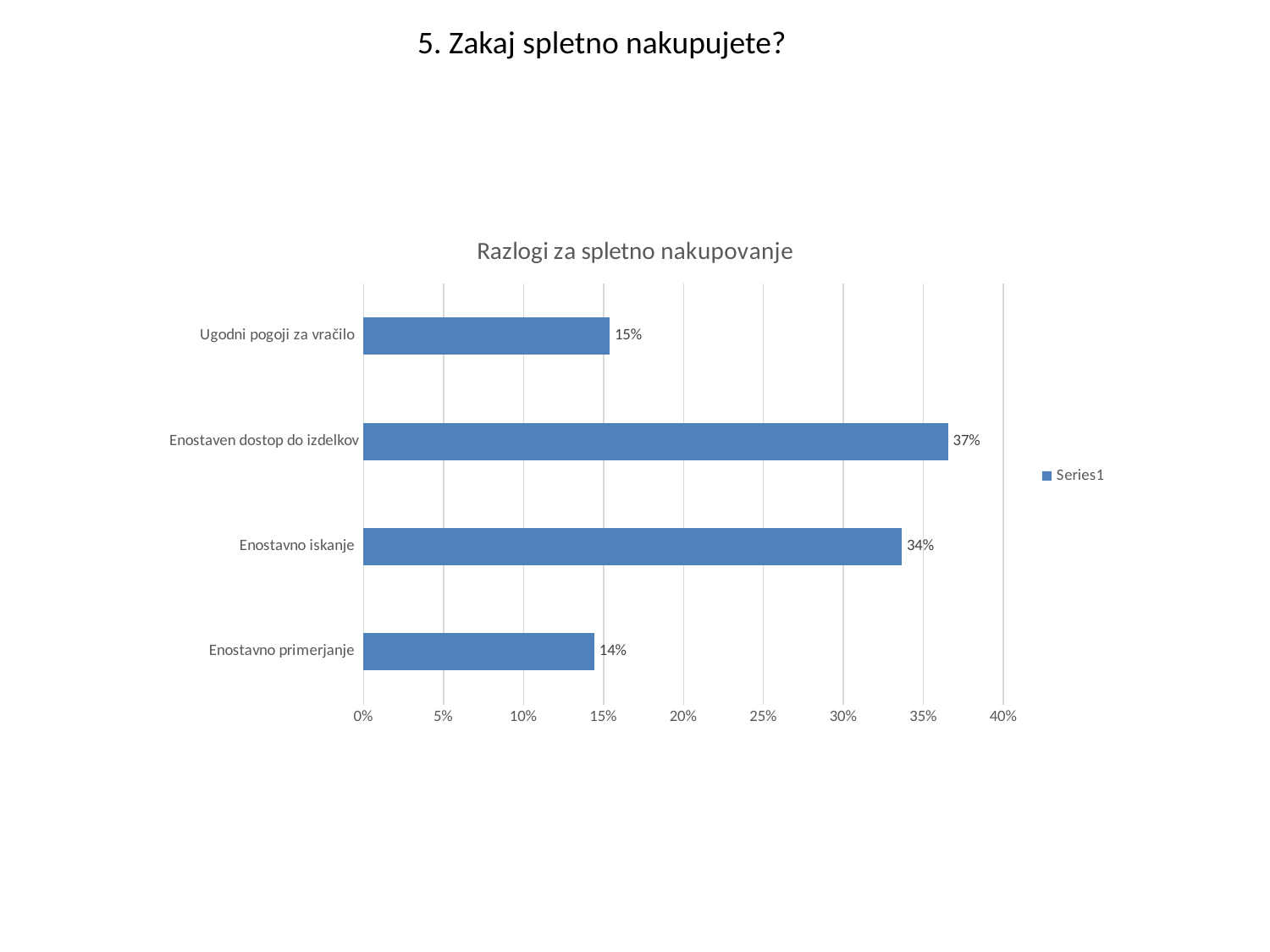
What is the title of the chart? Razlogi za spletno nakupovanje What is the value for Enostaven dostop do izdelkov? 37% What is the value for Enostavno iskanje? 34% Which category has the highest value? Enostaven dostop do izdelkov Which is larger, the value for Enostavno iskanje or the value for Ugodni pogoji za vračilo? Enostavno iskanje How many categories are shown in the chart? 4 Is the value for Enostavno iskanje greater or less than 30%? greater What is the difference between the values for Enostaven dostop do izdelkov and Enostavno iskanje? 3% What is the value for Enostavno primerjanje? 14% What is the value for Ugodni pogoji za vračilo? 15% What kind of chart is shown on the slide? Bar chart Which category has the lowest value? Enostavno primerjanje